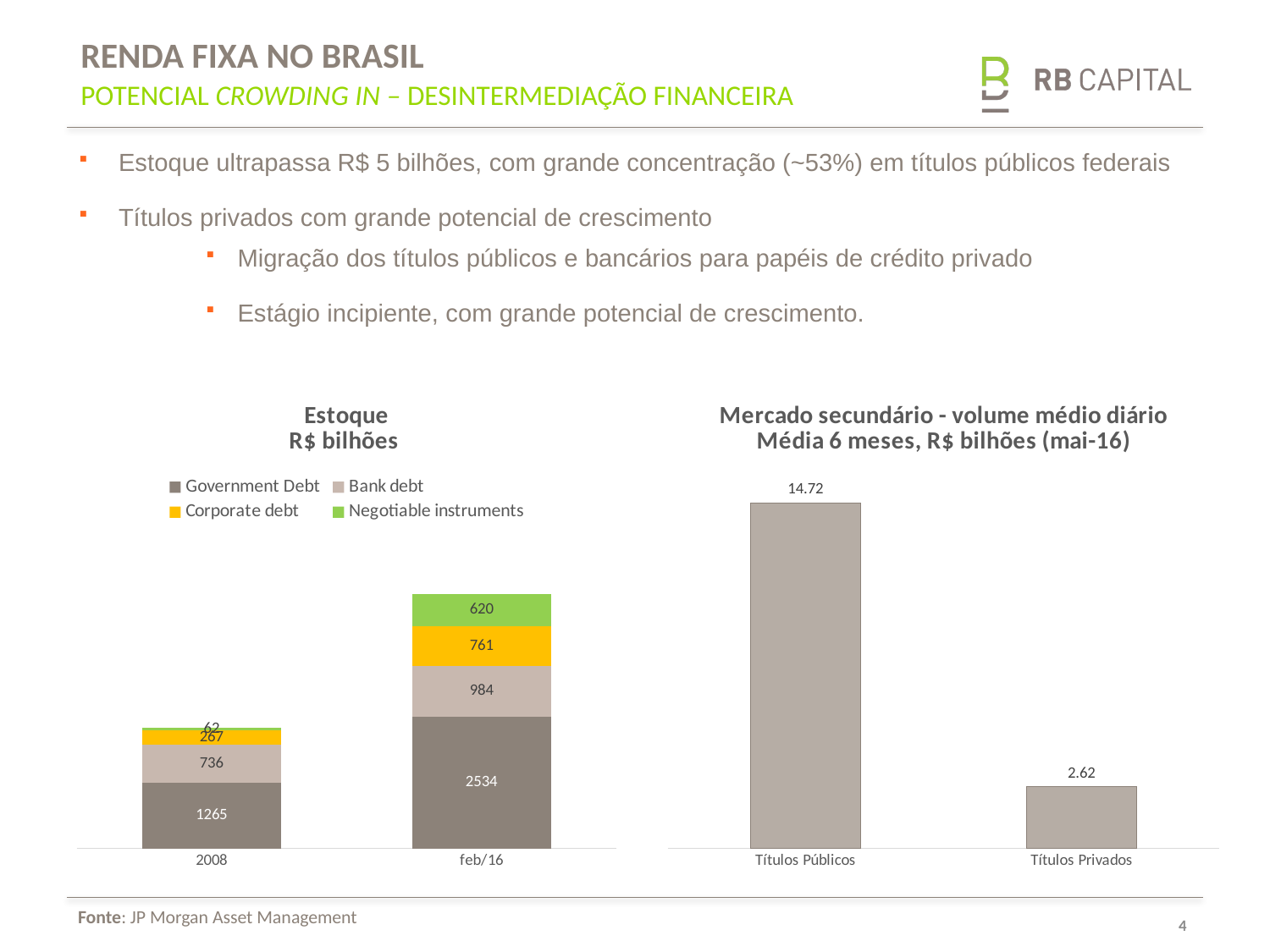
In the Estoque chart, how many series does the legend list? 4 In the Estoque chart, what is the Bank debt value for 2008? 736 What kind of chart is the Mercado secundário chart? Bar chart In the Mercado secundário chart, what is the difference between Títulos Públicos and Títulos Privados? 12.10 In the Estoque chart, what is the difference between the Government Debt values for feb/16 and 2008? 1269 In the Estoque chart, what is the Corporate debt value for feb/16? 761 In the Estoque chart, what is the Government Debt value for feb/16? 2534 In the Estoque chart, which series is the largest segment of the feb/16 bar? Government Debt In the Estoque chart, what is the Negotiable instruments value for feb/16? 620 In the Mercado secundário chart, what is the value for Títulos Privados? 2.62 In the Mercado secundário chart, what is the value for Títulos Públicos? 14.72 In the Estoque chart, what is the total of the stacked bar for feb/16? 4899